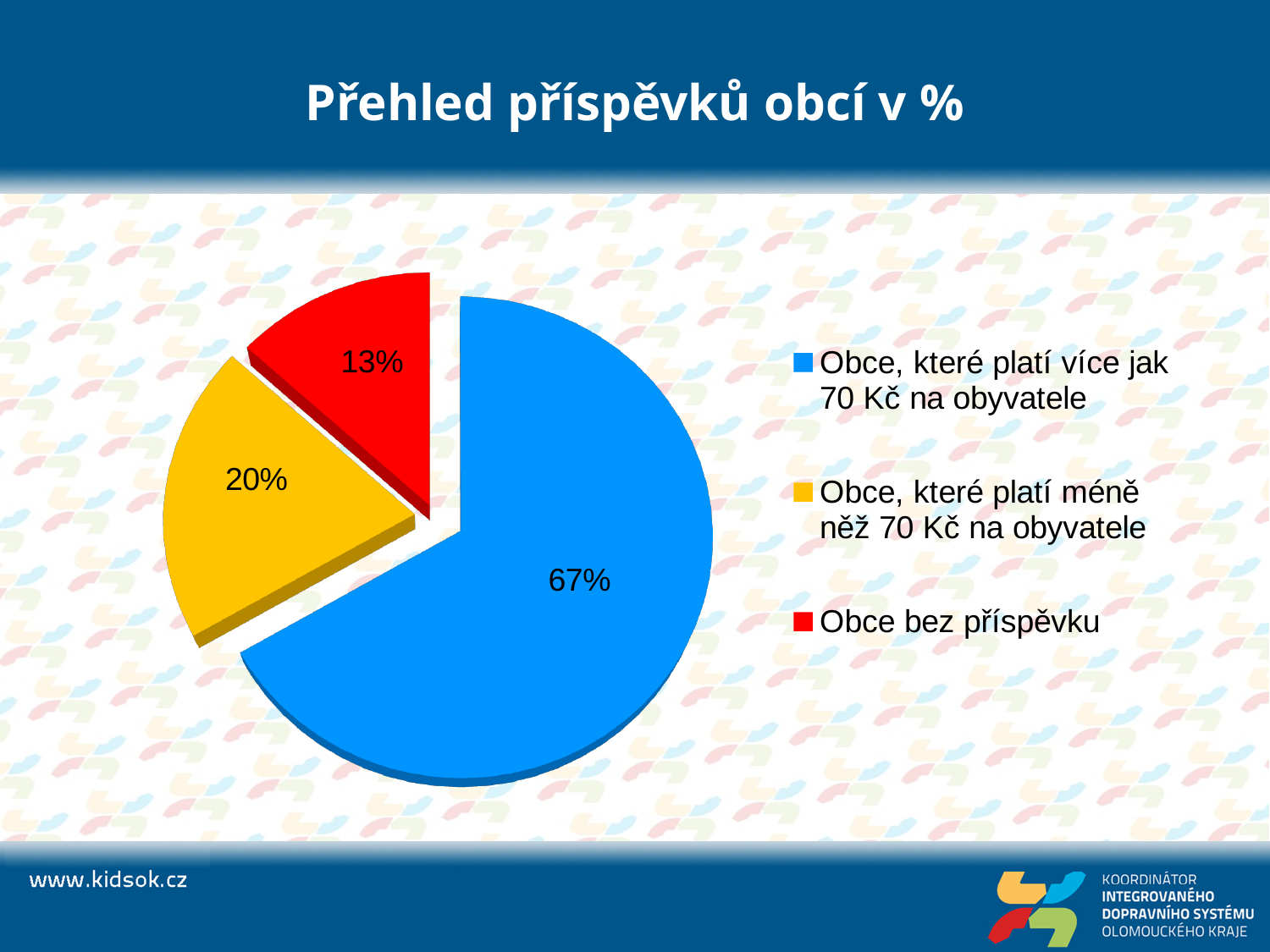
What share of the pie is labelled for 'Obce, které platí méně než 70 Kč na obyvatele'? 20% Which category has the smallest slice of the pie? Obce bez příspěvku What is the difference in percentage points between the slice for 'Obce, které platí méně než 70 Kč na obyvatele' and the slice for 'Obce bez příspěvku'? 7 percentage points What kind of chart is shown on the slide? pie chart What share of the pie is labelled for 'Obce, které platí více jak 70 Kč na obyvatele'? 67% What share of the pie is labelled for 'Obce bez příspěvku'? 13% What is the title of the chart on the slide? Přehled příspěvků obcí v % What is the difference in percentage points between the slice for 'Obce, které platí více jak 70 Kč na obyvatele' and the slice for 'Obce, které platí méně než 70 Kč na obyvatele'? 47 percentage points What colour is the slice for 'Obce bez příspěvku'? red How many slices does the pie chart have? 3 Which category has the largest slice of the pie? Obce, které platí více jak 70 Kč na obyvatele Which slice is larger: 'Obce, které platí méně než 70 Kč na obyvatele' or 'Obce bez příspěvku'? Obce, které platí méně než 70 Kč na obyvatele